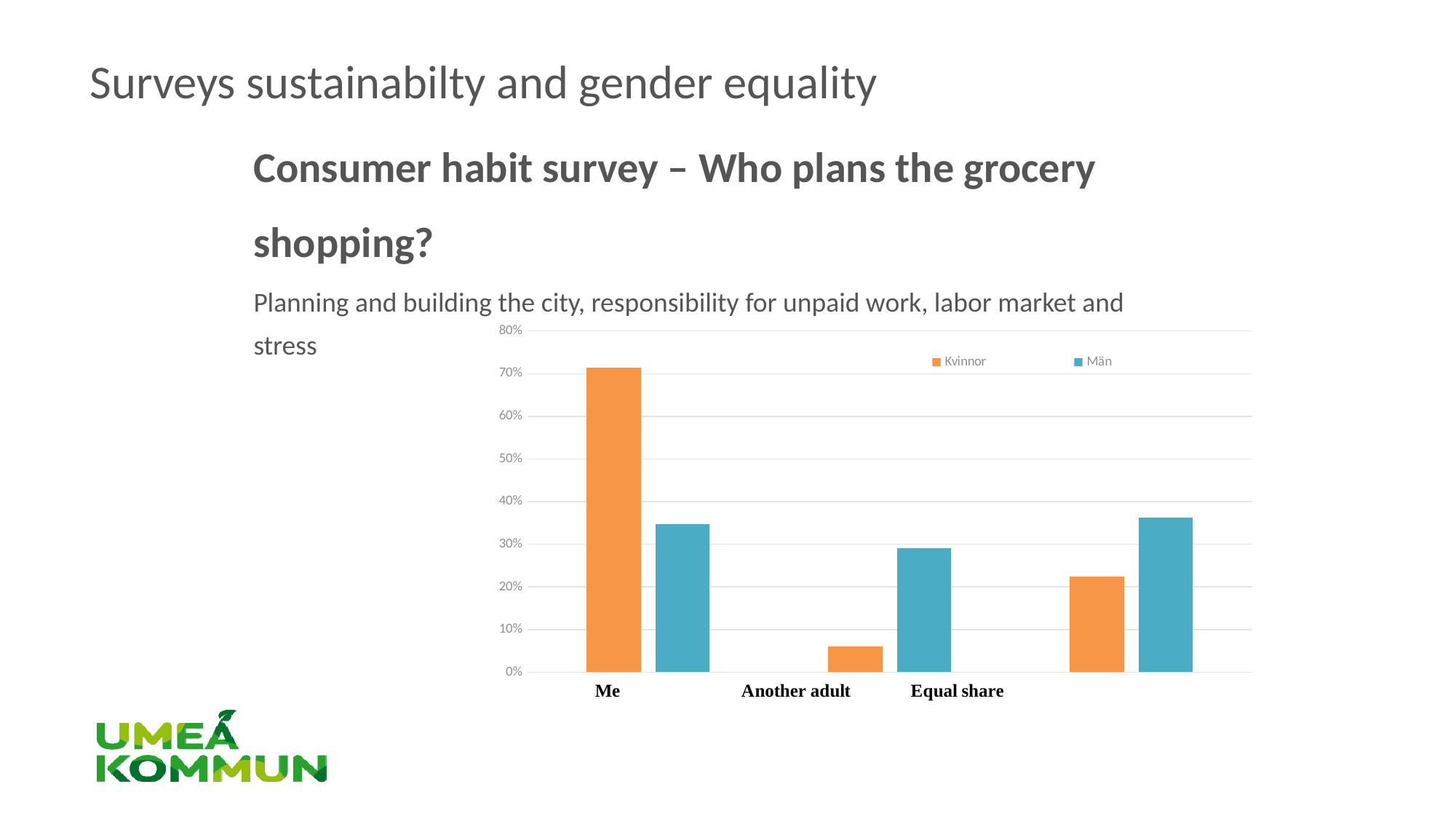
In the rightmost group of bars, which series has the larger value, Kvinnor or Män? Män In the leftmost group of bars, which series has the larger value, Kvinnor or Män? Kvinnor How many category labels are shown along the x axis of the chart? 3 Which colour represents the Kvinnor series in the chart? orange What kind of chart is shown on the slide? bar chart Is the tallest orange (Kvinnor) bar in the chart greater or less than 70%? greater Is the shortest orange (Kvinnor) bar in the chart greater or less than 10%? less How many series does the chart legend list? 2 Which group of bars contains the highest bar in the chart? the leftmost group Is the blue (Män) bar in the leftmost group of bars greater or less than 30%? greater What are the two series named in the chart legend? Kvinnor and Män